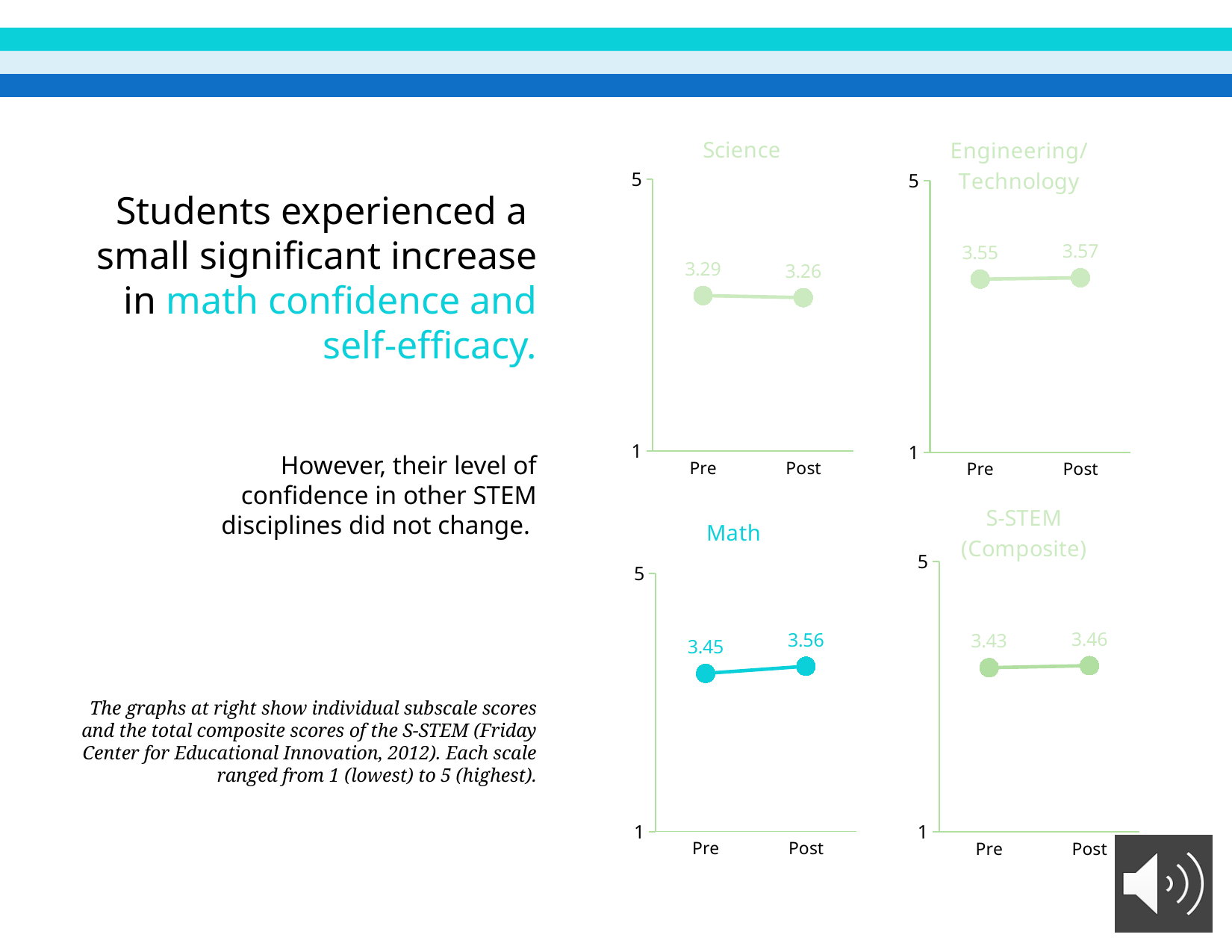
In the Science chart, what is the Pre value? 3.29 In the Science chart, what is the Post value? 3.26 What kind of chart is the Math chart? line chart In the Math chart, do the values rise or fall from Pre to Post? rise In the Science chart, do the values rise or fall from Pre to Post? fall In the Math chart, what is the Pre value? 3.45 How many data points are plotted in the S-STEM (Composite) chart? 2 In the Engineering/Technology chart, what is the Post value? 3.57 In the Math chart, what is the difference between the Post and Pre values? 0.11 In the S-STEM (Composite) chart, what is the Pre value? 3.43 How many charts are shown on the slide? 4 In the Science chart, what is the difference between the Pre and Post values? 0.03